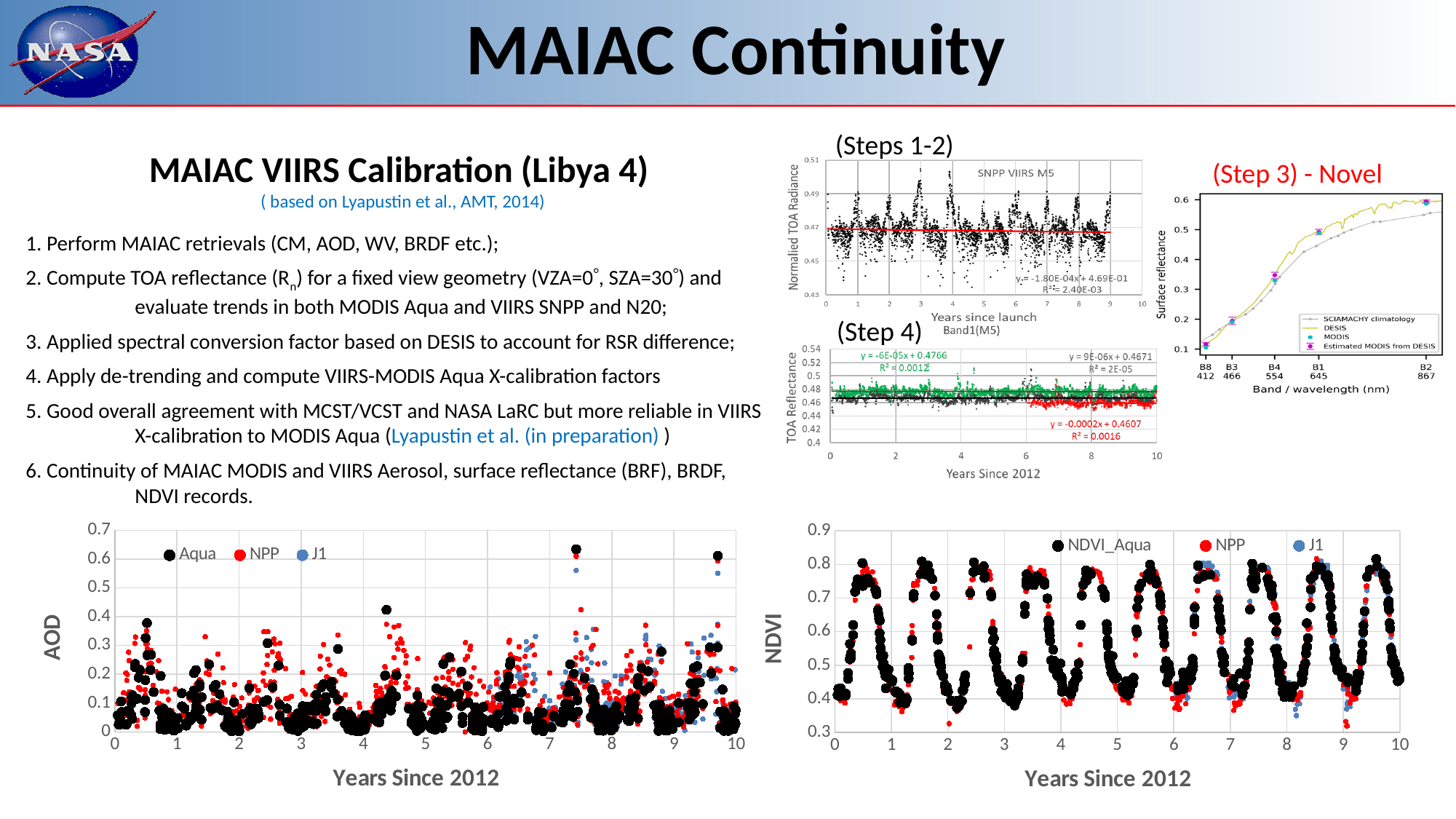
What kind of chart is the bottom-left AOD chart? Scatter chart On the Step 3 surface reflectance chart, how many series does the legend list? 4 What is the x-axis label of the bottom-right NDVI chart? Years Since 2012 On the SNPP VIIRS M5 chart (Steps 1-2), what R² value is printed for the fitted line? 2.40E-03 On the Step 4 TOA Reflectance chart, what is the equation printed in red for the fitted line? y = -0.0002x + 0.4607 On the Step 3 surface reflectance chart, does surface reflectance rise or fall as wavelength increases from B8 to B2? Rise On the bottom-left AOD chart, is the highest plotted AOD value greater or less than 0.5? greater On the bottom-left AOD chart, how many series does the legend list? 3 On the bottom-right NDVI chart, what are the three series named in the legend? NDVI_Aqua, NPP, J1 On the Step 3 surface reflectance chart, what wavelength is listed for band B4? 554 On the bottom-right NDVI chart, is the lowest plotted NDVI value greater or less than 0.4? less On the Step 3 surface reflectance chart, how many bands are shown on the x axis? 5